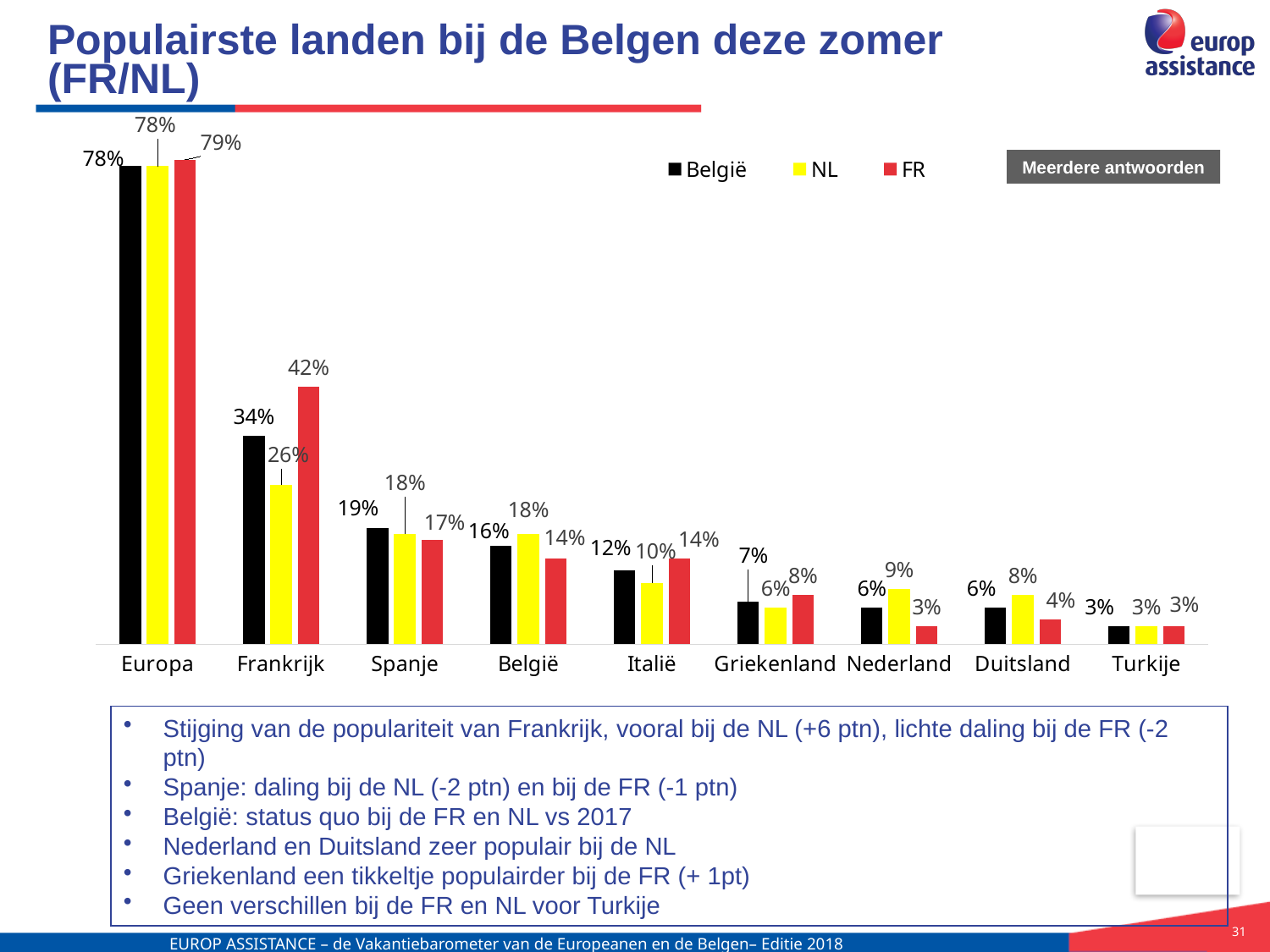
How many series does the legend list? 3 What type of chart is shown on the slide? bar chart What is the België value for Spanje? 19% What is the NL value for Nederland? 9% What is the difference between the België and FR values for Nederland? 3% Which category has the highest FR value? Europa What is the FR value for Frankrijk? 42% How many countries/categories are shown on the x axis? 9 For Italië, which is larger: the FR value or the NL value? FR What is the difference between the FR and NL values for Frankrijk? 16% Which series is shown in yellow in the legend? NL Which category has the lowest België value? Turkije